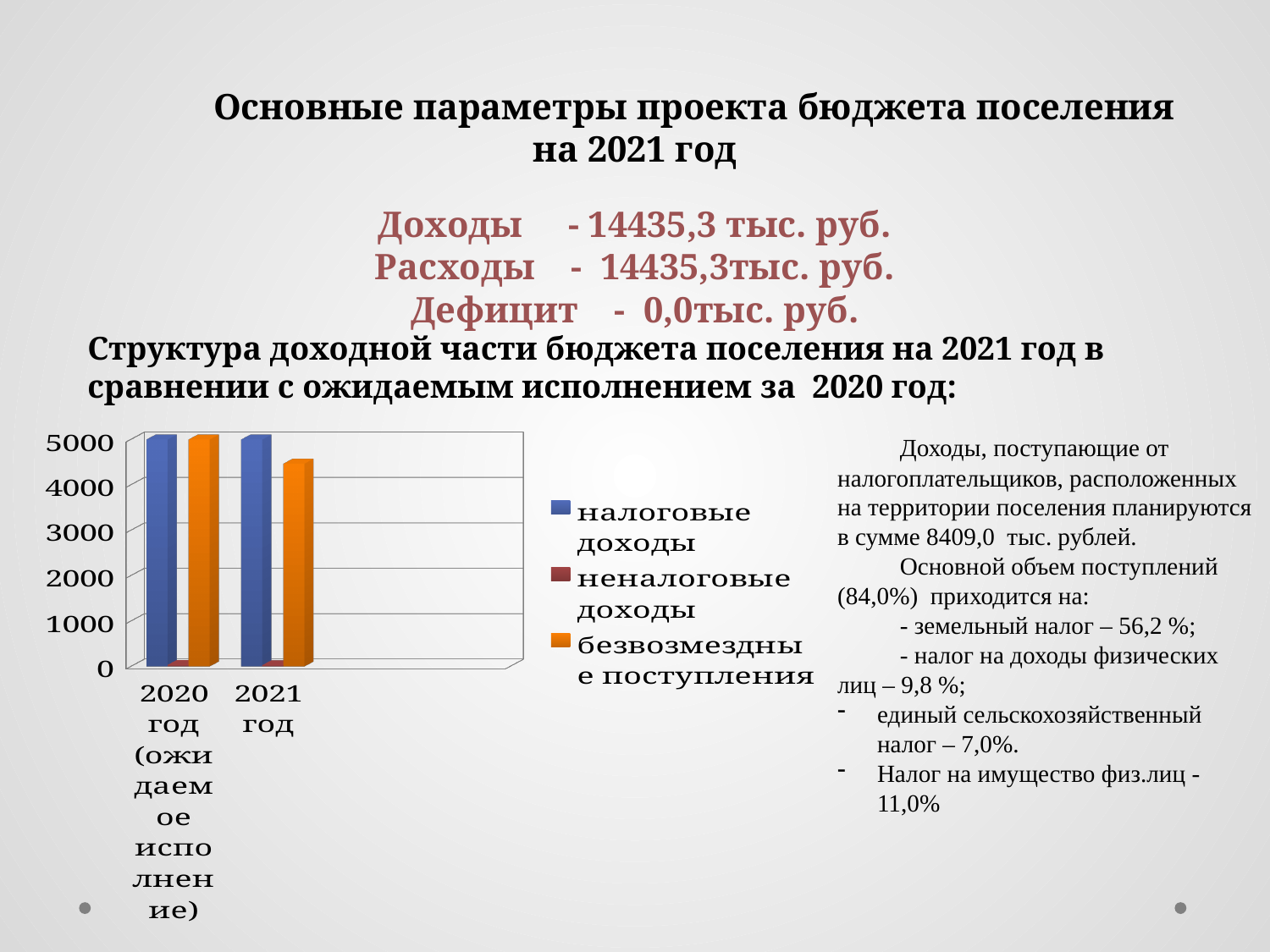
Is the value for неналоговые доходы in 2020 год greater or less than 1000? less What kind of chart is shown on the slide? bar chart What colour represents безвозмездные поступления in the chart legend? orange Which is larger: безвозмездные поступления in 2020 год or in 2021 год? 2020 год Is the value for налоговые доходы in 2021 год greater or less than 4000? greater Is the value for безвозмездные поступления in 2021 год greater or less than 4000? greater Which is larger in 2021 год: налоговые доходы or неналоговые доходы? налоговые доходы Do the values for безвозмездные поступления rise or fall from 2020 год to 2021 год? fall How many series does the chart legend list? 3 How many categories (years) are shown on the x axis of the chart? 2 Which series has the lowest value in 2021 год? неналоговые доходы